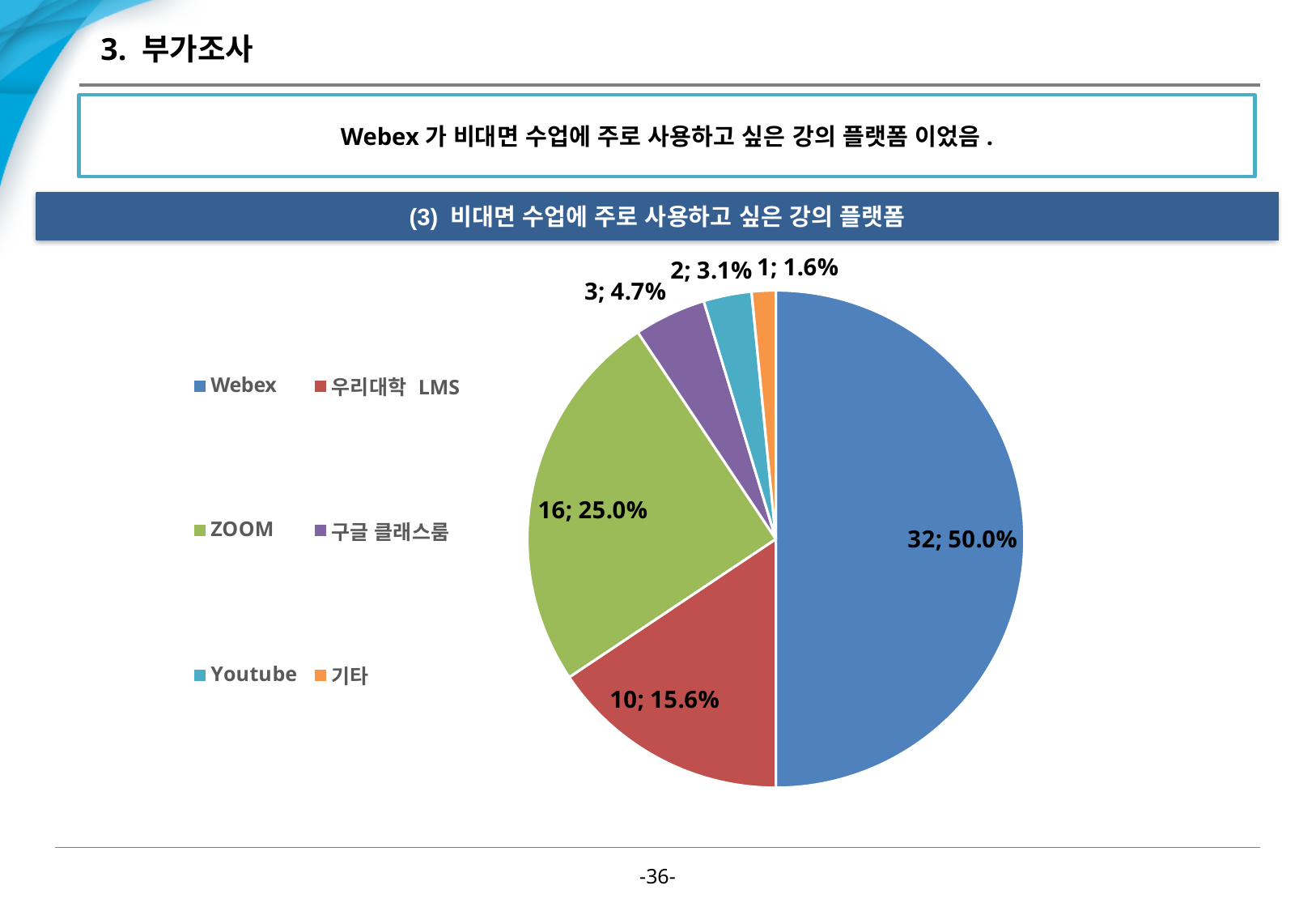
What kind of chart is shown on the slide? pie chart Which category has the smallest slice in the pie chart? 기타 What is the count for 우리대학 LMS in the pie chart? 10 What is the count for Webex in the pie chart? 32 How many categories does the pie chart have? 6 What is the count for Youtube in the pie chart? 2 Which has a larger count, 우리대학 LMS or ZOOM? ZOOM What percentage share does 구글 클래스룸 have in the pie chart? 4.7% Which category has the largest slice in the pie chart? Webex What percentage share does ZOOM have in the pie chart? 25.0% What is the title of the chart section on the slide? (3) 비대면 수업에 주로 사용하고 싶은 강의 플랫폼 What is the difference in count between Webex and ZOOM? 16